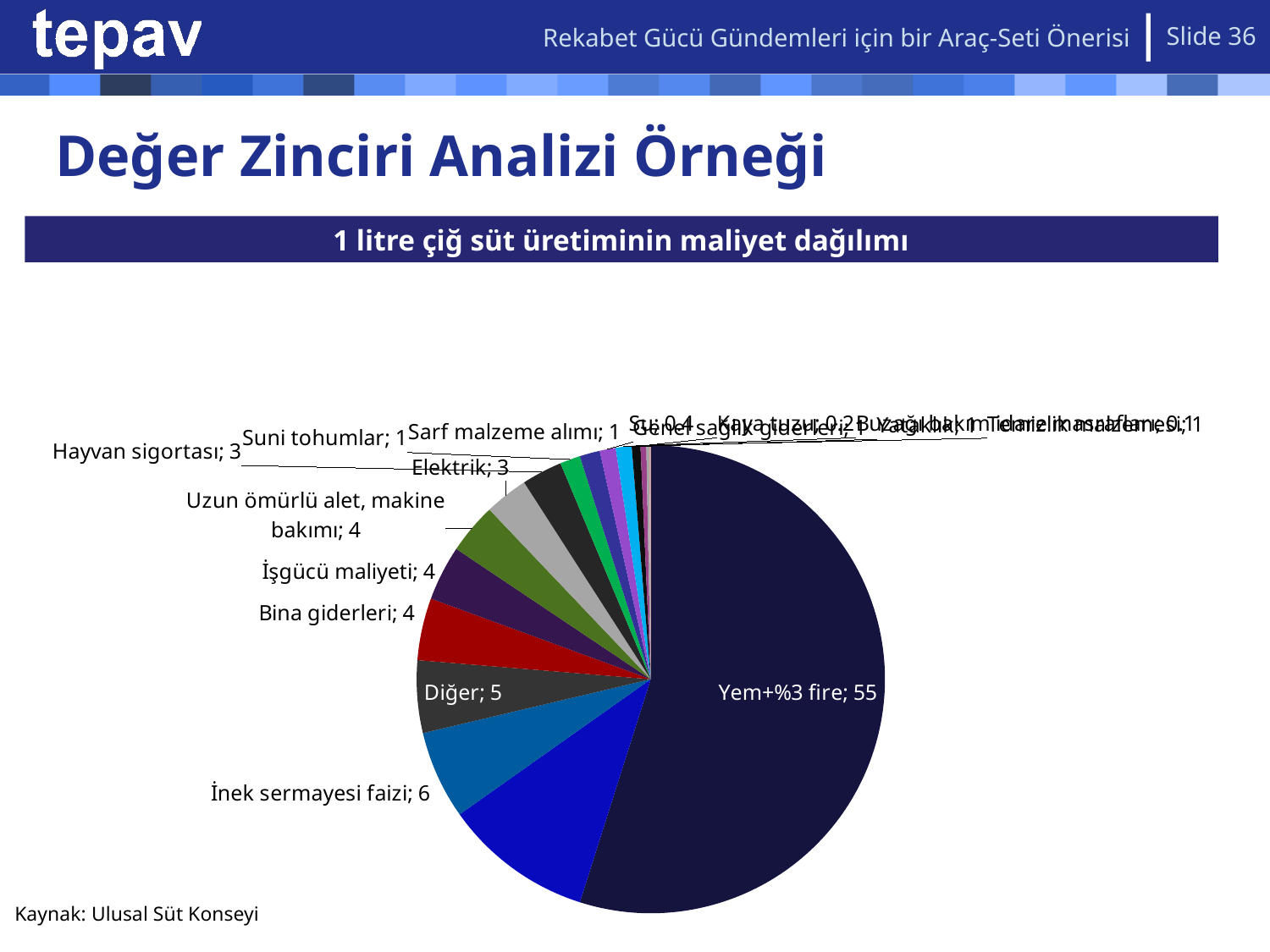
What is the value for İnek sermayesi faizi? 6 What is the value for Yem+%3 fire? 55 What is the title of the chart? 1 litre çiğ süt üretiminin maliyet dağılımı Which category has the largest slice of the pie? Yem+%3 fire Which is larger, the value for Diğer or the value for Elektrik? Diğer What is the value for Su? 0.4 What kind of chart is shown on the slide? pie chart What is the value for Hayvan sigortası? 3 What is the value for Suni tohumlar? 1 What is the difference between the values for Yem+%3 fire and İnek sermayesi faizi? 49 What is the value for Diğer? 5 What is the value for Bina giderleri? 4